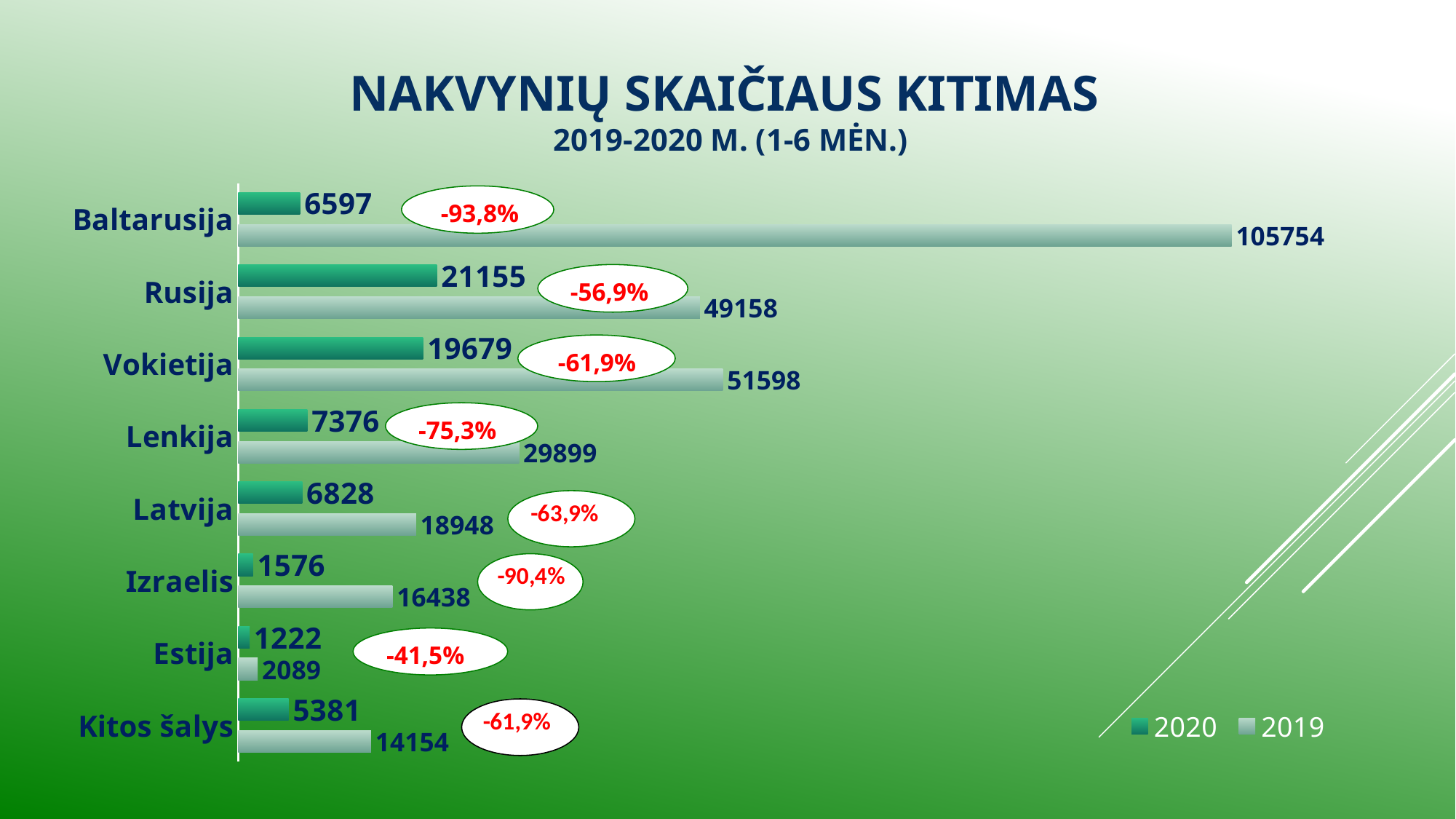
How many series does the legend list? 2 What is the difference between the 2019 and 2020 values for Lenkija? 22523 Which category has the lowest value in the 2020 series? Estija What is the value for Rusija in the 2020 series? 21155 What is the value for Latvija in the 2019 series? 18948 What is the value for Vokietija in the 2019 series? 51598 Which is larger in the 2020 series: Rusija or Vokietija? Rusija What kind of chart is shown on the slide? Bar chart Which category has the highest value in the 2019 series? Baltarusija How many categories are shown on the chart? 8 Which category has the highest value in the 2020 series? Rusija What is the difference between the 2019 and 2020 values for Baltarusija? 99157